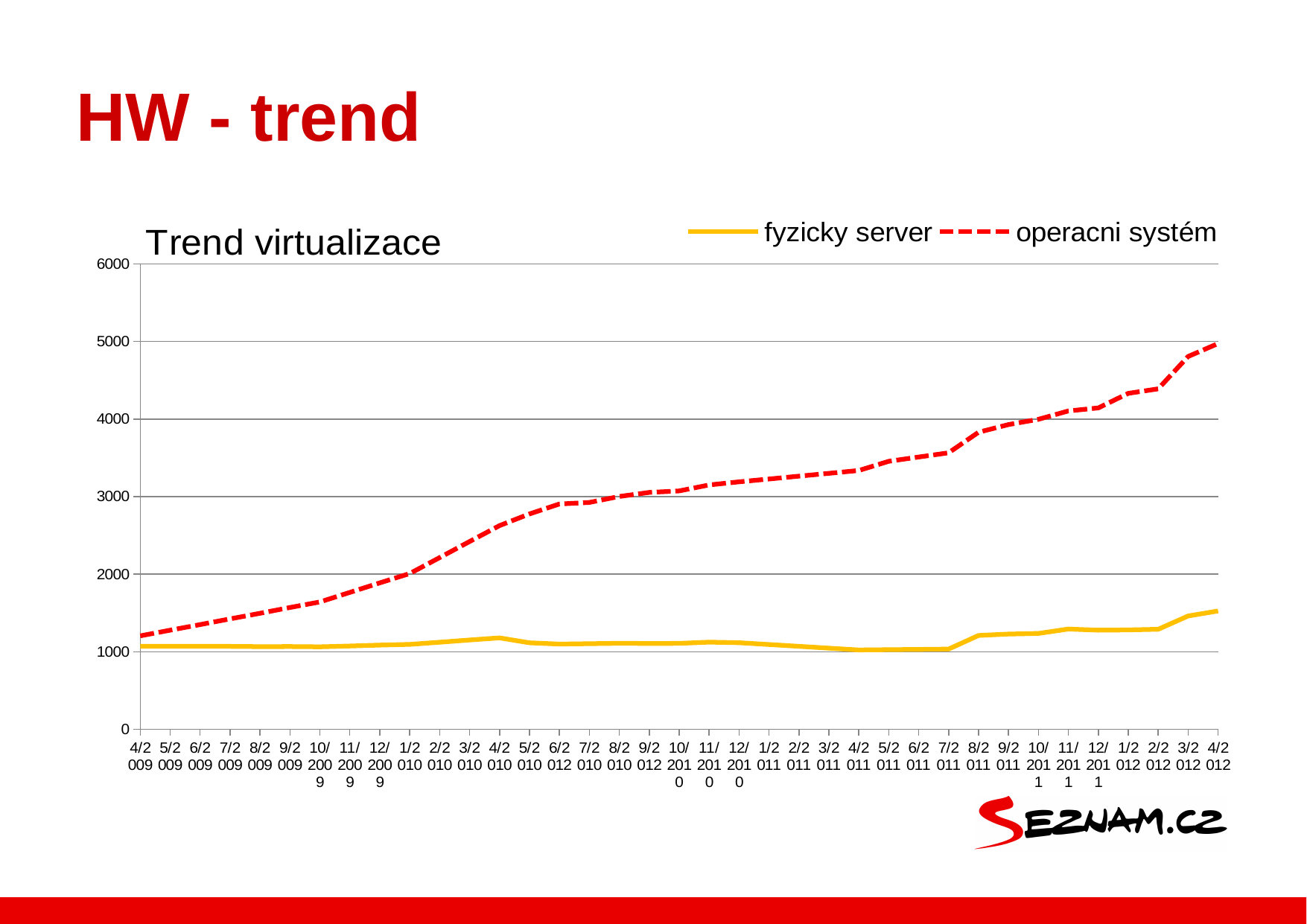
Is the value for operacni systém at 7/2011 greater or less than 3000? greater How many series does the legend list? 2 What is the title of the chart? Trend virtualizace What kind of chart is shown on the slide? line chart Does the operacni systém series rise or fall from 4/2009 to 4/2012? rise At which date does the operacni systém series reach its highest value? 4/2012 Is the value for fyzicky server at 4/2012 greater or less than 1000? greater Is the value for operacni systém at 4/2009 greater or less than 2000? less Which series is drawn with a red dashed line? operacni systém At 4/2012, which series has the larger value, fyzicky server or operacni systém? operacni systém